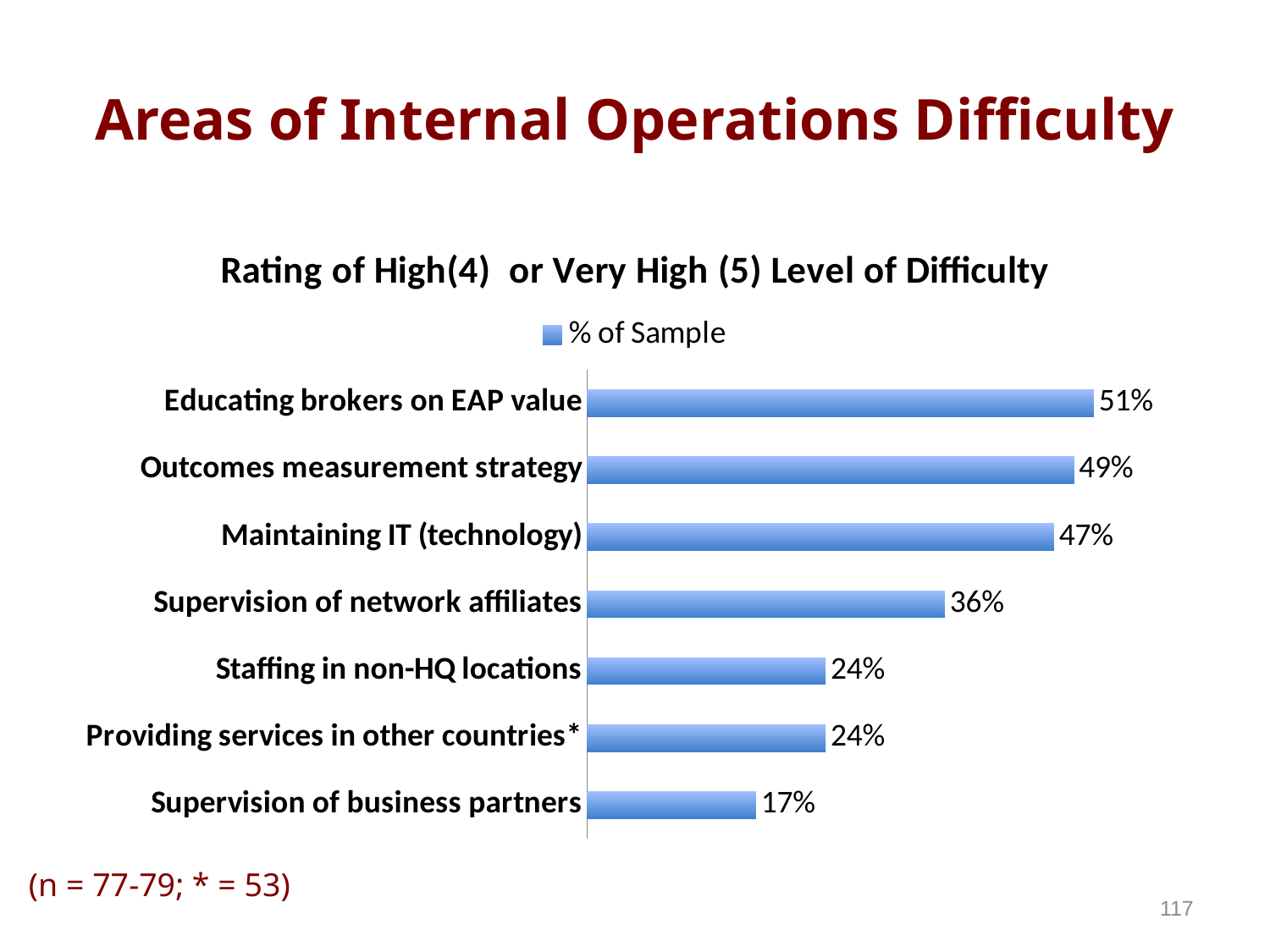
How many series does the legend list? 1 How many areas of internal operations difficulty are shown in the chart? 7 What percentage of the sample rated Educating brokers on EAP value as a high or very high difficulty? 51% What kind of chart is shown on the slide? Bar chart What is the value for Supervision of business partners? 17% What is the difference between the values for Maintaining IT (technology) and Supervision of network affiliates? 11% What is the value for Supervision of network affiliates? 36% Which area has the highest percentage of the sample rating it as high or very high difficulty? Educating brokers on EAP value Which is larger, the value for Outcomes measurement strategy or the value for Staffing in non-HQ locations? Outcomes measurement strategy What is the name of the series shown in the legend? % of Sample Which area has the lowest percentage? Supervision of business partners What is the difference between the values for Educating brokers on EAP value and Supervision of business partners? 34%